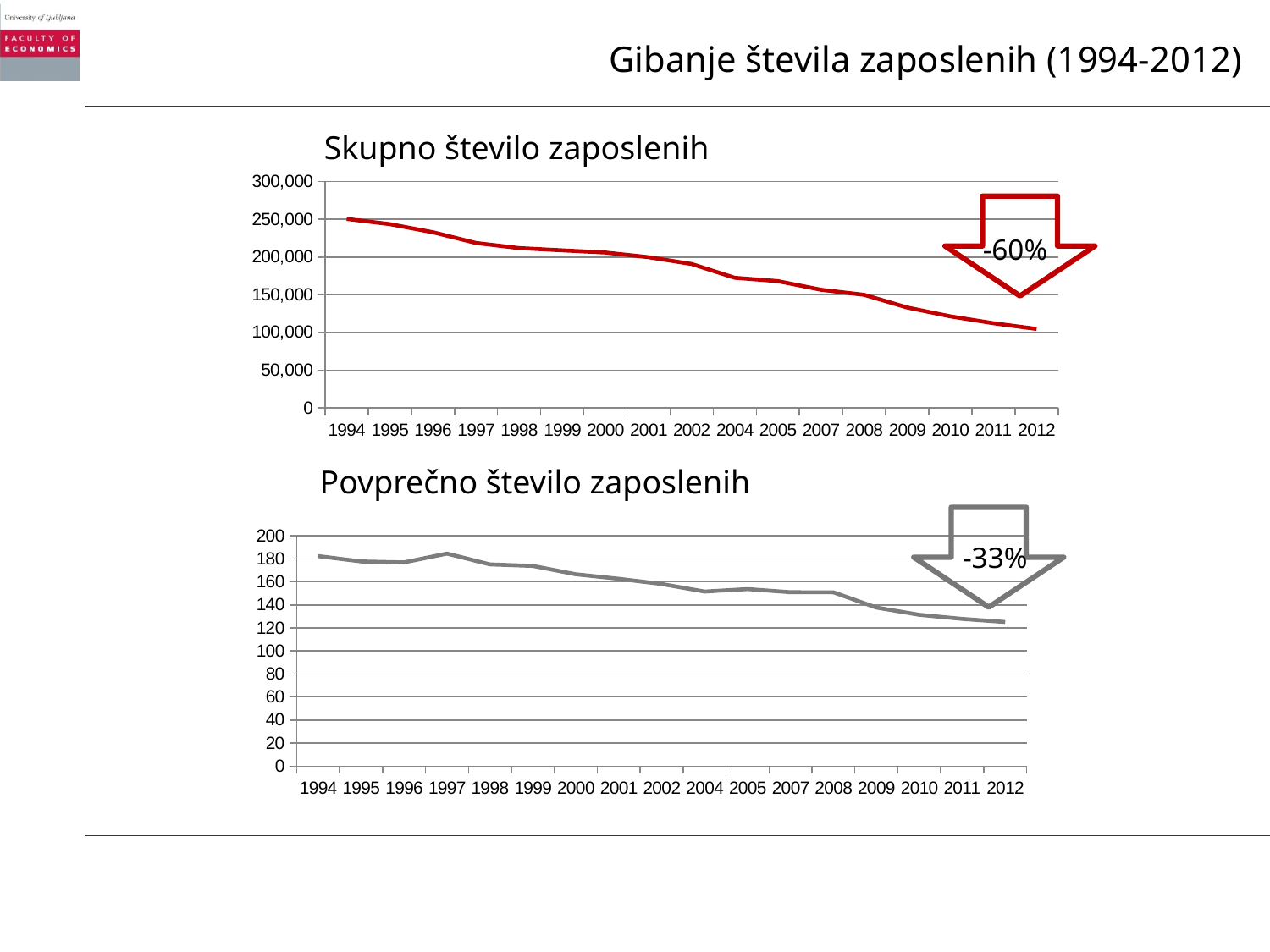
In the 'Skupno število zaposlenih' chart, which year has the highest value? 1994 What kind of chart is the 'Skupno število zaposlenih' chart? line chart In the 'Povprečno število zaposlenih' chart, which is larger, the value for 1997 or the value for 2004? 1997 How many years are plotted on the x axis of the 'Skupno število zaposlenih' chart? 17 What percentage change is written inside the arrow on the 'Skupno število zaposlenih' chart? -60% In the 'Povprečno število zaposlenih' chart, is the value for 2010 greater or less than 140? less In the 'Skupno število zaposlenih' chart, is the value for 2002 greater or less than 200,000? less In the 'Povprečno število zaposlenih' chart, which year has the lowest value? 2012 In the 'Skupno število zaposlenih' chart, do the values rise or fall from 1994 to 2012? fall In the 'Skupno število zaposlenih' chart, which year has the lowest value? 2012 In the 'Povprečno število zaposlenih' chart, is the value for 2012 greater or less than 120? greater